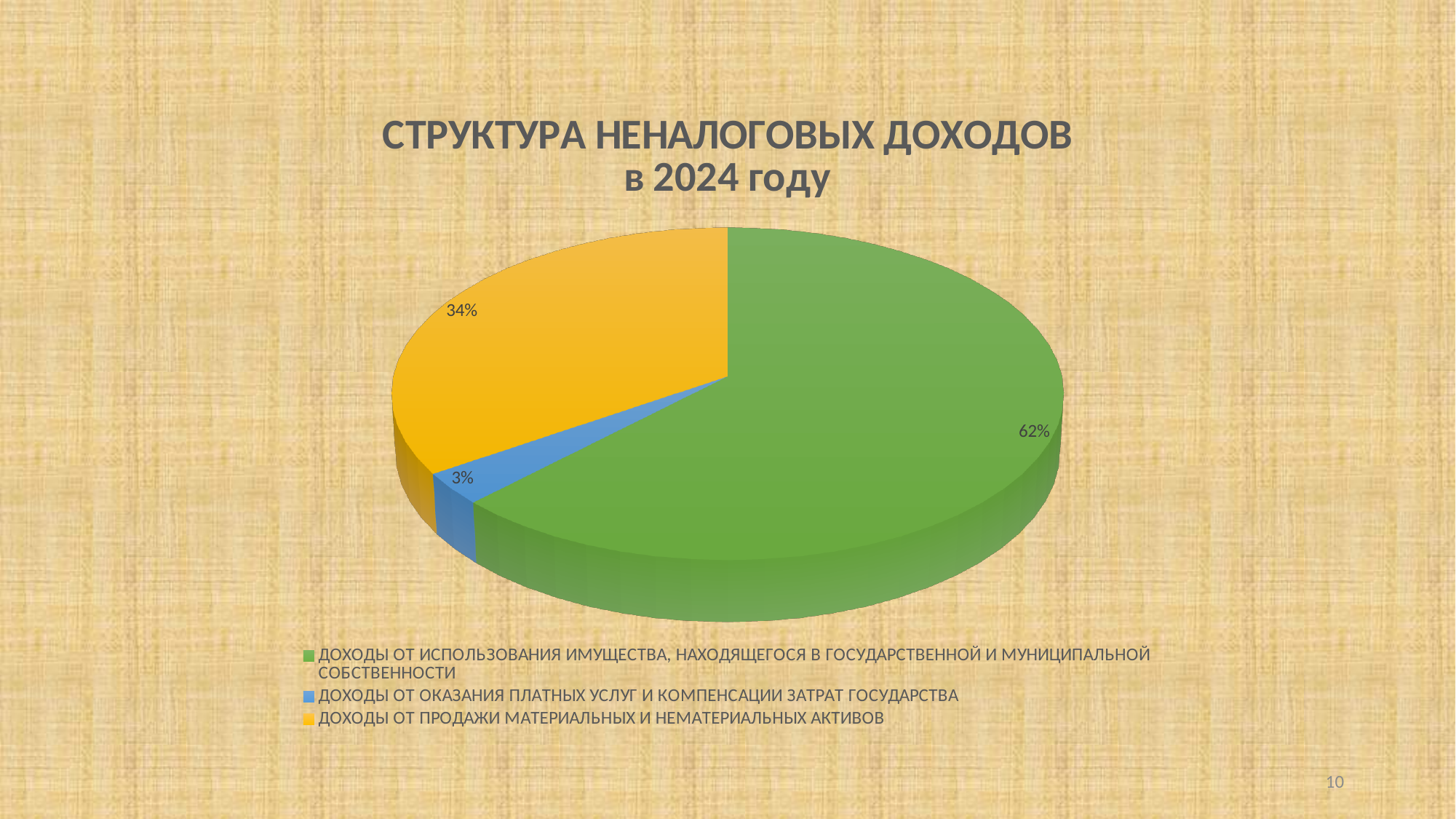
What is the difference in percentage points between the slice for ДОХОДЫ ОТ ИСПОЛЬЗОВАНИЯ ИМУЩЕСТВА and the slice for ДОХОДЫ ОТ ПРОДАЖИ МАТЕРИАЛЬНЫХ И НЕМАТЕРИАЛЬНЫХ АКТИВОВ? 28% What share of the pie is labelled for ДОХОДЫ ОТ ИСПОЛЬЗОВАНИЯ ИМУЩЕСТВА, НАХОДЯЩЕГОСЯ В ГОСУДАРСТВЕННОЙ И МУНИЦИПАЛЬНОЙ СОБСТВЕННОСТИ? 62% What share of the pie is labelled for ДОХОДЫ ОТ ОКАЗАНИЯ ПЛАТНЫХ УСЛУГ И КОМПЕНСАЦИИ ЗАТРАТ ГОСУДАРСТВА? 3% Which is larger: the slice for ДОХОДЫ ОТ ПРОДАЖИ МАТЕРИАЛЬНЫХ И НЕМАТЕРИАЛЬНЫХ АКТИВОВ or the slice for ДОХОДЫ ОТ ОКАЗАНИЯ ПЛАТНЫХ УСЛУГ И КОМПЕНСАЦИИ ЗАТРАТ ГОСУДАРСТВА? ДОХОДЫ ОТ ПРОДАЖИ МАТЕРИАЛЬНЫХ И НЕМАТЕРИАЛЬНЫХ АКТИВОВ How many slices does the pie chart have? 3 What colour is the slice for ДОХОДЫ ОТ ОКАЗАНИЯ ПЛАТНЫХ УСЛУГ И КОМПЕНСАЦИИ ЗАТРАТ ГОСУДАРСТВА? Blue What is the difference in percentage points between the slice for ДОХОДЫ ОТ ПРОДАЖИ МАТЕРИАЛЬНЫХ И НЕМАТЕРИАЛЬНЫХ АКТИВОВ and the slice for ДОХОДЫ ОТ ОКАЗАНИЯ ПЛАТНЫХ УСЛУГ? 31% Which category has the largest slice of the pie? ДОХОДЫ ОТ ИСПОЛЬЗОВАНИЯ ИМУЩЕСТВА, НАХОДЯЩЕГОСЯ В ГОСУДАРСТВЕННОЙ И МУНИЦИПАЛЬНОЙ СОБСТВЕННОСТИ What share of the pie is labelled for ДОХОДЫ ОТ ПРОДАЖИ МАТЕРИАЛЬНЫХ И НЕМАТЕРИАЛЬНЫХ АКТИВОВ? 34% Which category has the smallest slice of the pie? ДОХОДЫ ОТ ОКАЗАНИЯ ПЛАТНЫХ УСЛУГ И КОМПЕНСАЦИИ ЗАТРАТ ГОСУДАРСТВА What is the title of the chart? СТРУКТУРА НЕНАЛОГОВЫХ ДОХОДОВ в 2024 году What kind of chart is shown on the slide? Pie chart